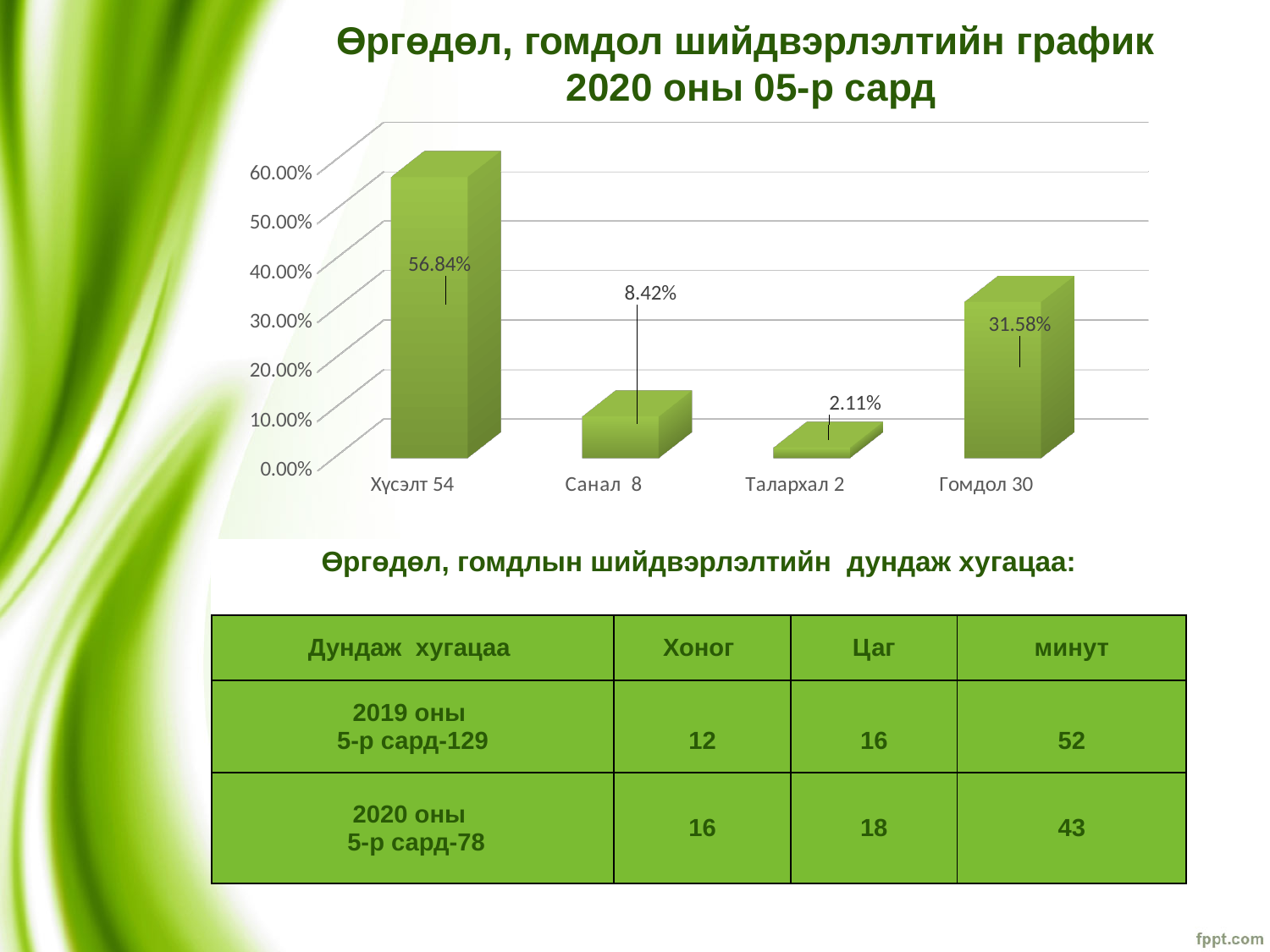
What is the value shown for Санал 8? 8.42% Is the value for Гомдол 30 greater or less than 40.00%? less How many categories are shown on the chart? 4 What is the value shown for Гомдол 30? 31.58% Which category has the highest value? Хүсэлт 54 What is the difference between the values for Хүсэлт 54 and Гомдол 30? 25.26% What is the value shown for Хүсэлт 54? 56.84% Which is larger, the value for Санал 8 or the value for Гомдол 30? Гомдол 30 What is the title of the chart? Өргөдөл, гомдол шийдвэрлэлтийн график 2020 оны 05-р сард What kind of chart is shown on the slide? bar chart Which category has the lowest value? Талархал 2 What is the value shown for Талархал 2? 2.11%